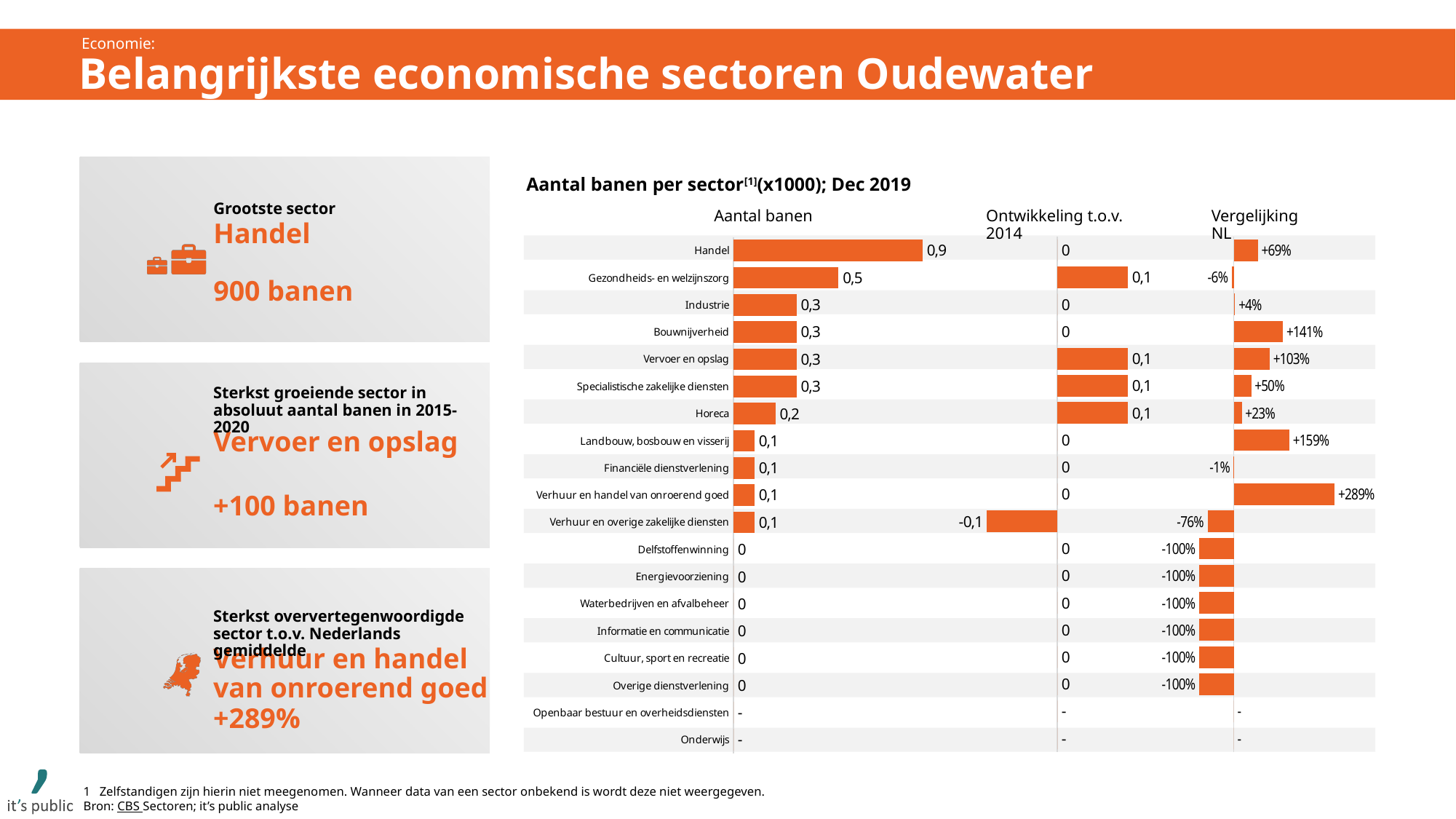
How many sectors are listed in the chart? 19 Which sector has the highest value in the 'Vergelijking NL' column? Verhuur en handel van onroerend goed In the 'Vergelijking NL' column, which is larger: Vervoer en opslag or Specialistische zakelijke diensten? Vervoer en opslag In the 'Ontwikkeling t.o.v. 2014' column, what is the value for Verhuur en overige zakelijke diensten? -0,1 Which sector has the lowest value in the 'Ontwikkeling t.o.v. 2014' column? Verhuur en overige zakelijke diensten Which sector has the highest value in the 'Aantal banen' column? Handel In the 'Aantal banen' column, which is larger: Gezondheids- en welzijnszorg or Horeca? Gezondheids- en welzijnszorg In the 'Aantal banen' column, what is the value for Handel? 0,9 In the 'Vergelijking NL' column, what is the value for Bouwnijverheid? +141% In the 'Vergelijking NL' column, what is the value for Verhuur en handel van onroerend goed? +289% In the 'Aantal banen' column, what is the difference between Handel and Gezondheids- en welzijnszorg? 0,4 What type of chart is used to show the values per sector? Bar chart